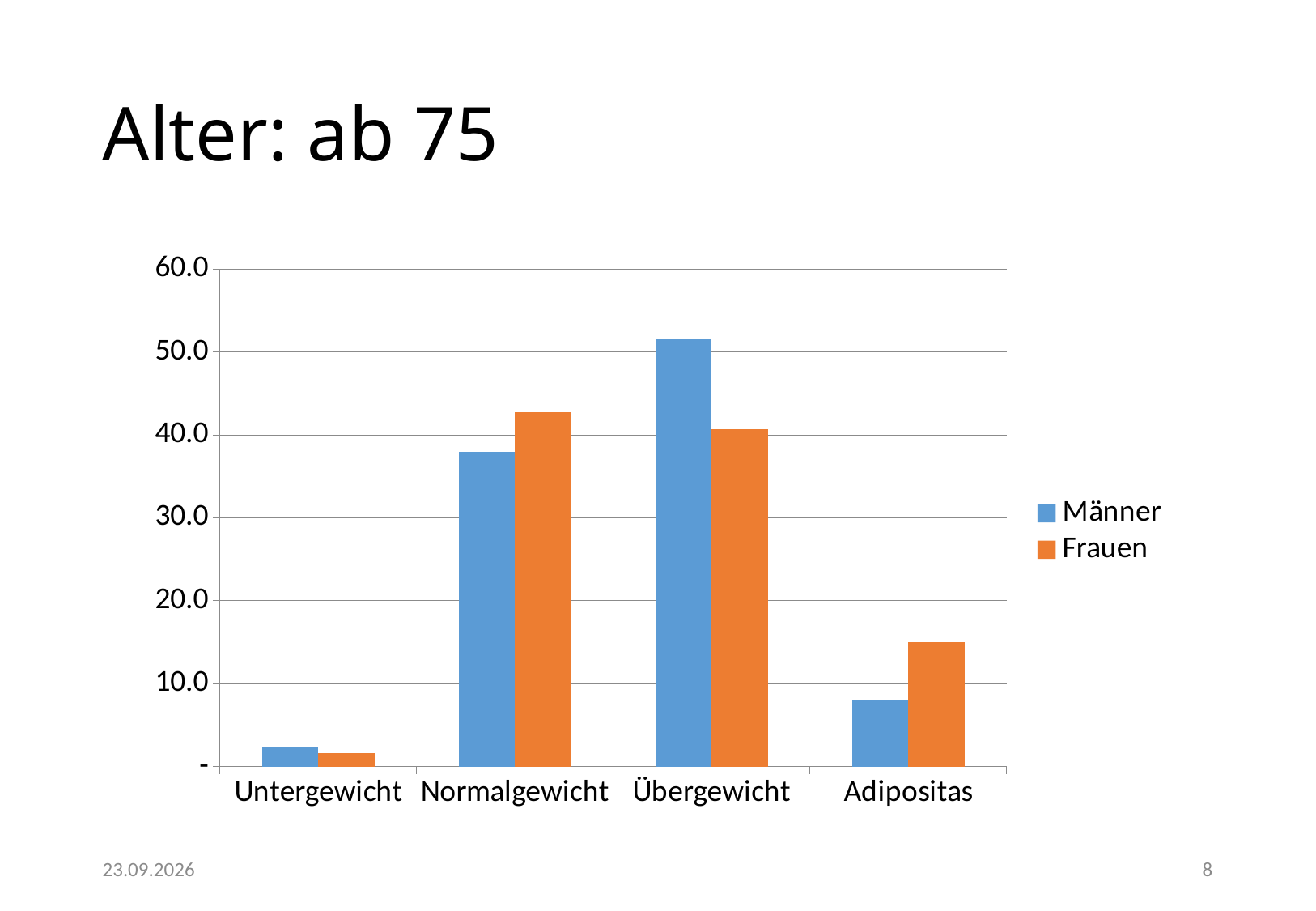
Which category has the highest value for Frauen? Normalgewicht How many categories are shown on the x axis of the chart? 4 Which category has the highest value for Männer? Übergewicht How many series does the legend list? 2 In the Normalgewicht category, which series has the larger value, Männer or Frauen? Frauen Is the value for Frauen in Adipositas greater or less than 10.0? greater Is the value for Männer in Übergewicht greater or less than 50.0? greater Is the value for Männer in Normalgewicht greater or less than 40.0? less What kind of chart is shown on the slide? bar chart Which category has the lowest value for Frauen? Untergewicht In the Übergewicht category, which series has the larger value, Männer or Frauen? Männer Which colour represents the Frauen series in the chart? orange